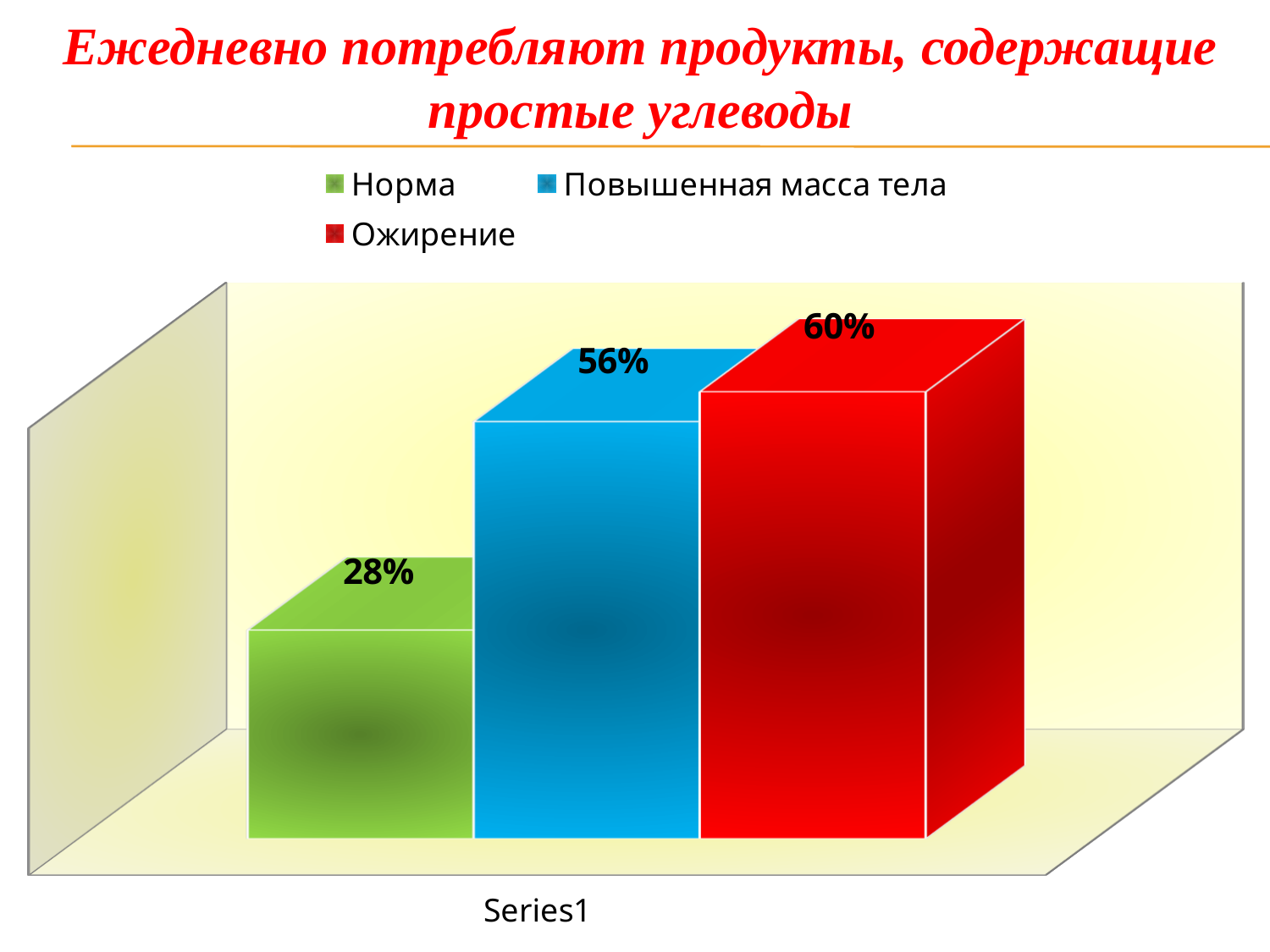
Which group has the highest value? Ожирение How many series does the legend list? 3 What is the difference between the values for Повышенная масса тела and Норма? 28% Which is larger, the value for Норма or the value for Повышенная масса тела? Повышенная масса тела Which group has the lowest value? Норма What is the value for Ожирение? 60% How many bars are plotted on the chart? 3 What colour is the bar for Ожирение? Red What is the difference between the values for Ожирение and Норма? 32% What kind of chart is shown on the slide? Bar chart What is the value for Норма? 28% What is the value for Повышенная масса тела? 56%